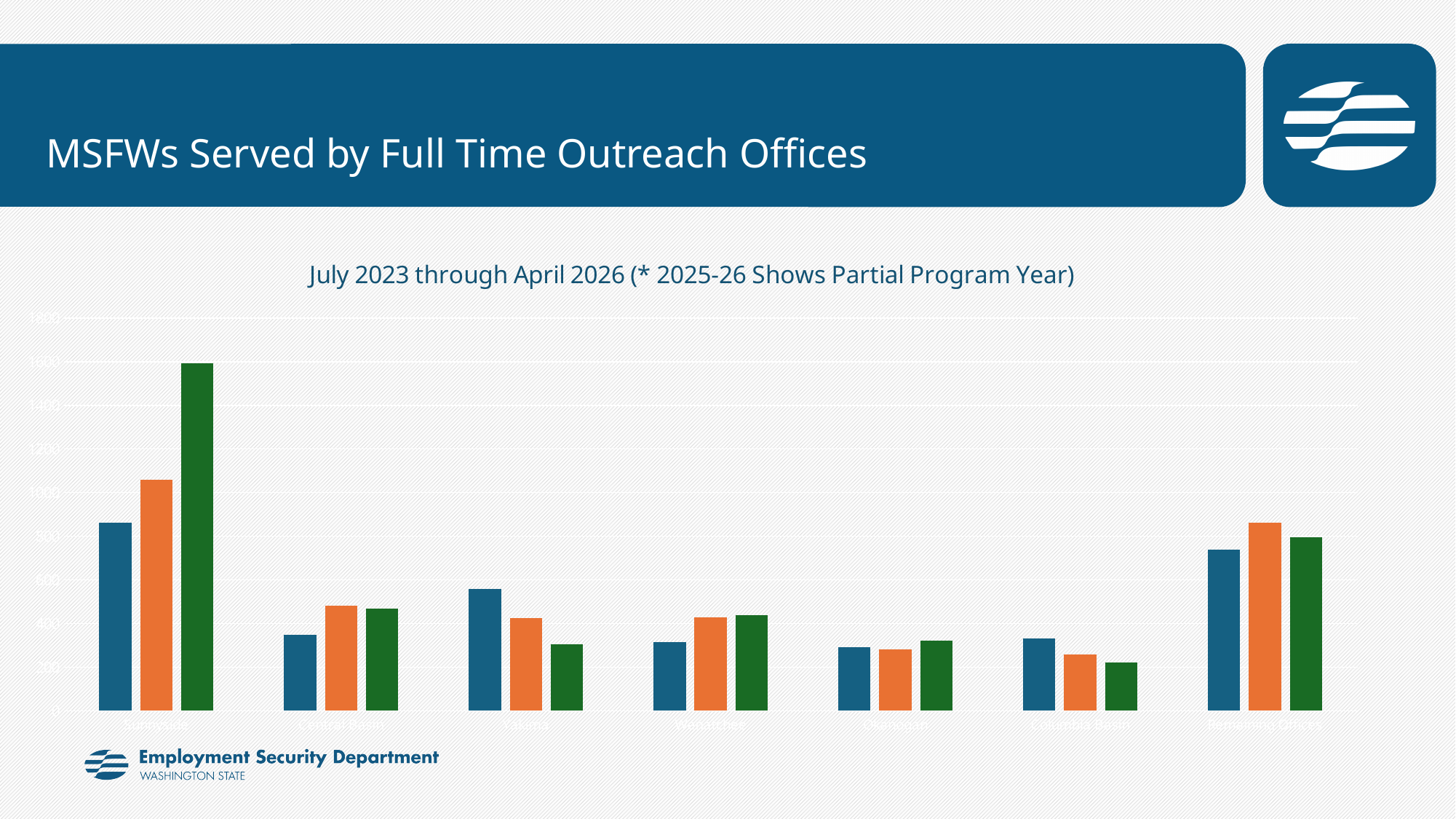
Is the blue bar in the leftmost category group greater or less than 1000? less What is the subtitle printed above the chart? July 2023 through April 2026 (* 2025-26 Shows Partial Program Year) In the rightmost category group, which bar is the tallest: the blue, the orange, or the green one? orange In the leftmost category group, is the green bar taller or shorter than the blue bar? taller How many bars are there in each category group? 3 Which category group contains the tallest bar on the chart? the leftmost (first) group What is the title of the slide? MSFWs Served by Full Time Outreach Offices Which category group has the shortest green bar? the sixth group from the left How many groups of bars (categories) are plotted on the chart? 7 In the leftmost category group, which bar is the tallest: the blue, the orange, or the green one? green Is the tallest bar on the chart greater or less than 1400? greater What kind of chart is shown on the slide? bar chart